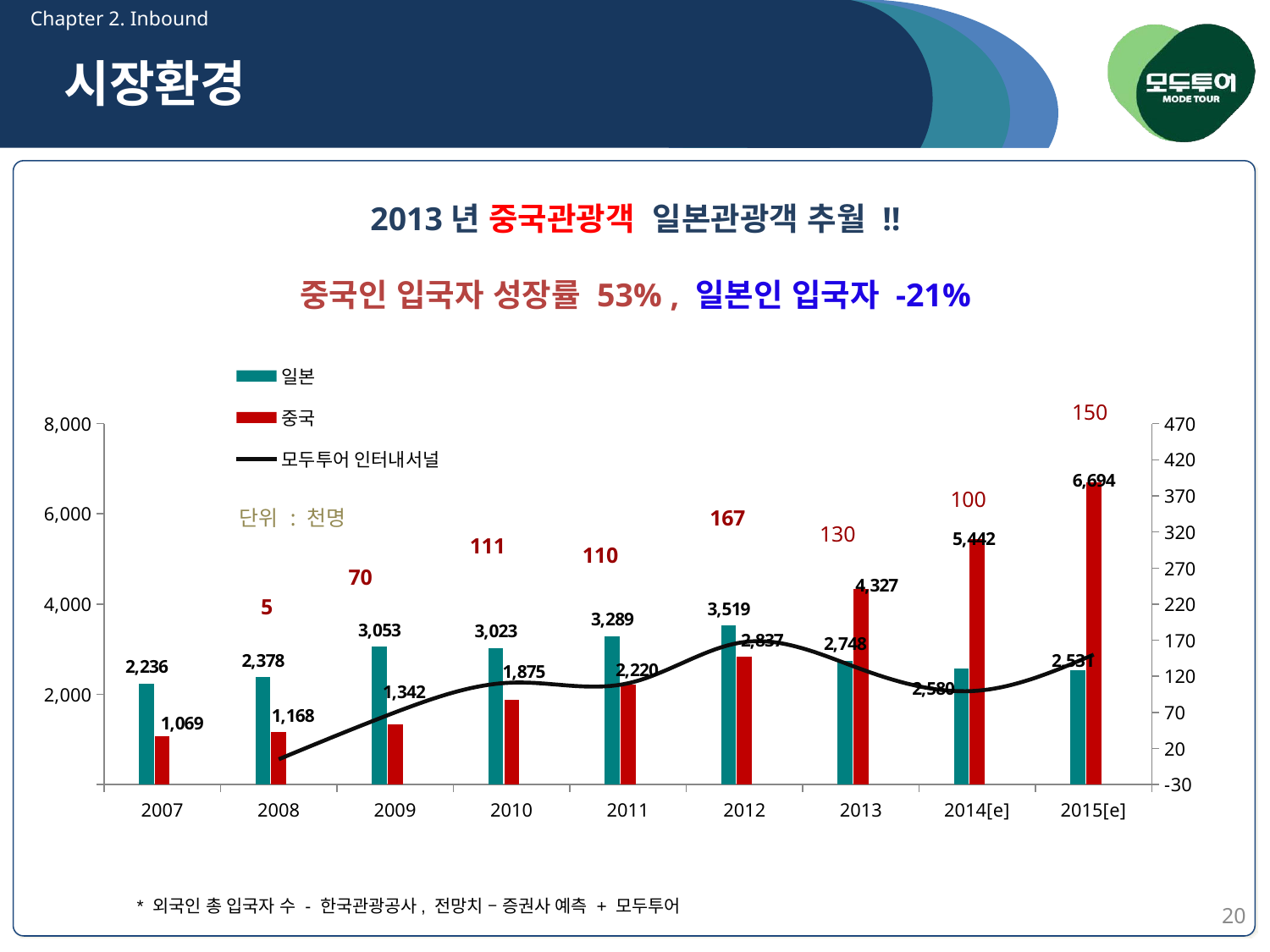
What is the value for 중국 in 2015[e]? 6,694 Does the 중국 series rise or fall from 2007 to 2015[e]? Rise What is the value for 중국 in 2007? 1,069 Which is larger in 2011, the 일본 value or the 중국 value? 일본 In which year is the 일본 series highest? 2012 How many series does the legend list? 3 In which year is the 중국 series lowest? 2007 What kind of chart is this? Combined bar and line chart What is the value for 일본 in 2012? 3,519 What is the value of the 모두투어 인터내셔널 line in 2012? 167 What is the difference between the 중국 and 일본 values in 2013? 1,579 How many years are shown on the x axis? 9